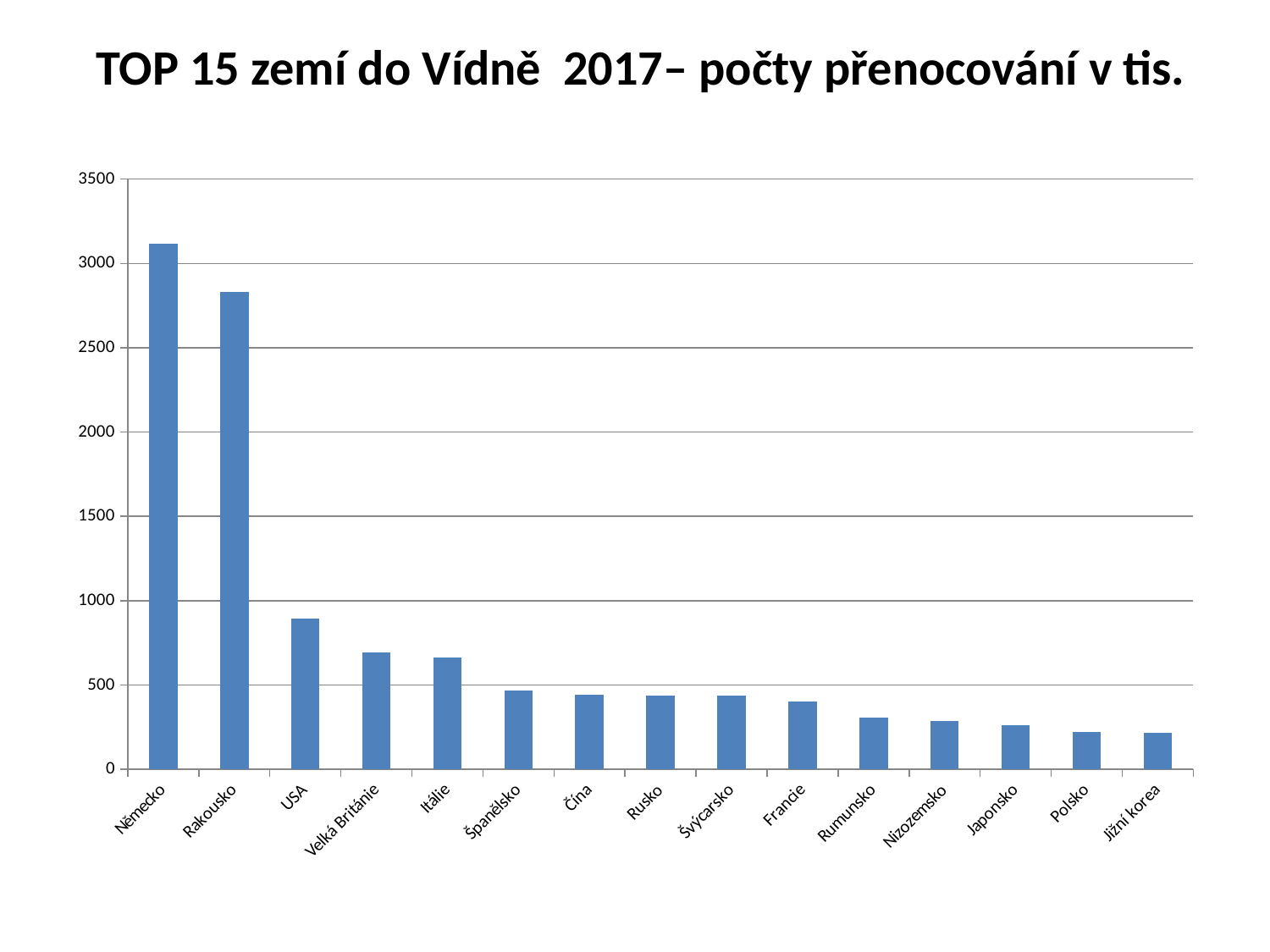
Is the value for USA greater or less than 1000? less Is the value for Velká Británie greater or less than 500? greater Is the value for Francie greater or less than 500? less Do the values rise or fall from left to right along the x axis? fall What kind of chart is shown on the slide? bar chart How many countries are shown on the x axis of the chart? 15 Which has a larger value, USA or Velká Británie? USA Which country has the highest number of overnight stays in the chart? Německo Which has a larger value, Německo or Rakousko? Německo What is the title of the chart on the slide? TOP 15 zemí do Vídně 2017– počty přenocování v tis.